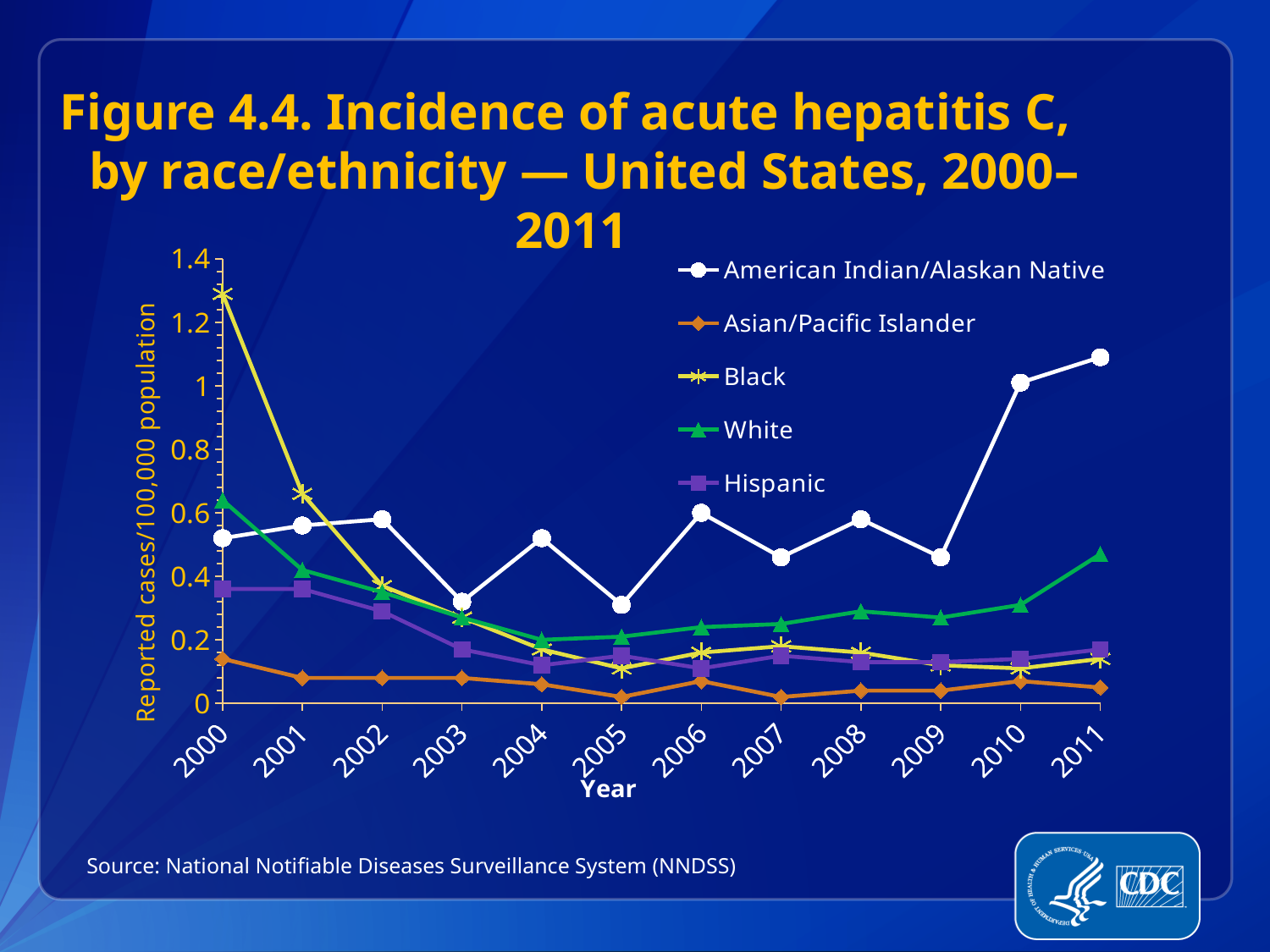
Is the value for Black in 2000 greater or less than 1? greater How many years are plotted along the x axis? 12 What kind of chart is shown on the slide? Line chart Which race/ethnicity group has the highest incidence in 2000? Black In 2011, which is larger: the value for White or the value for Hispanic? White Which race/ethnicity group has the lowest incidence in 2005? Asian/Pacific Islander Is the value for White in 2011 greater or less than 0.6? less How many series does the legend list? 5 Is the value for American Indian/Alaskan Native in 2011 greater or less than 1? greater What is the label on the y axis? Reported cases/100,000 population Which race/ethnicity group has the highest incidence in 2011? American Indian/Alaskan Native Does the incidence for Black rise or fall from 2000 to 2005? Fall